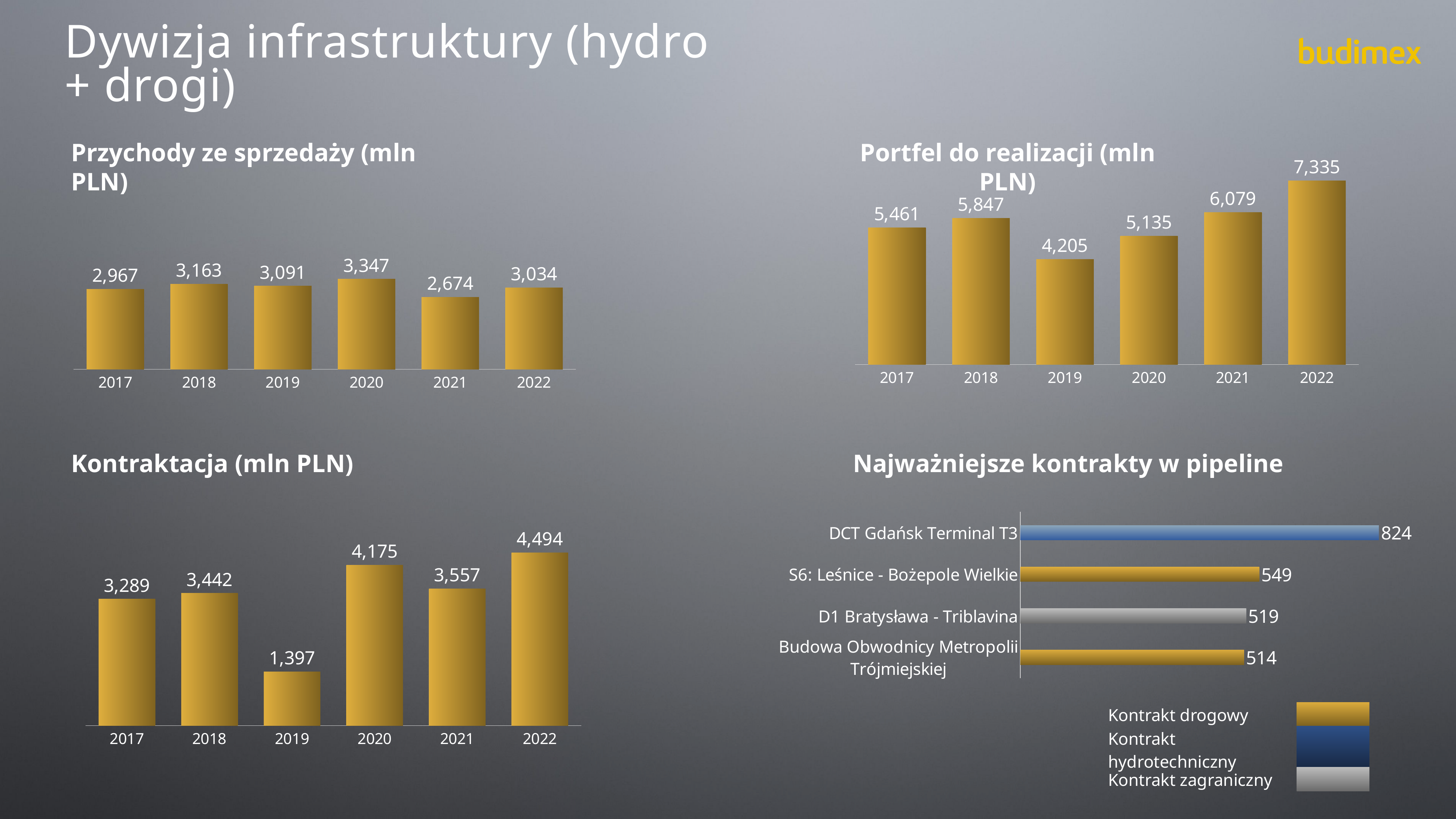
In the 'Najważniejsze kontrakty w pipeline' chart, what is the value for DCT Gdańsk Terminal T3? 824 How many entries does the legend of the 'Najważniejsze kontrakty w pipeline' chart list? 3 In the 'Przychody ze sprzedaży (mln PLN)' chart, what is the value for 2020? 3,347 In the 'Portfel do realizacji (mln PLN)' chart, which is larger, the value for 2017 or the value for 2020? 2017 In the 'Portfel do realizacji (mln PLN)' chart, which year has the highest value? 2022 How many years are shown in the 'Kontraktacja (mln PLN)' chart? 6 In the 'Przychody ze sprzedaży (mln PLN)' chart, which year has the lowest value? 2021 In the 'Portfel do realizacji (mln PLN)' chart, what is the value for 2019? 4,205 In the 'Najważniejsze kontrakty w pipeline' chart, which contract has the lowest value? Budowa Obwodnicy Metropolii Trójmiejskiej In the 'Przychody ze sprzedaży (mln PLN)' chart, what is the difference between the 2020 and 2021 values? 673 In the 'Kontraktacja (mln PLN)' chart, what is the difference between the 2022 and 2021 values? 937 In the 'Kontraktacja (mln PLN)' chart, what is the value for 2019? 1,397